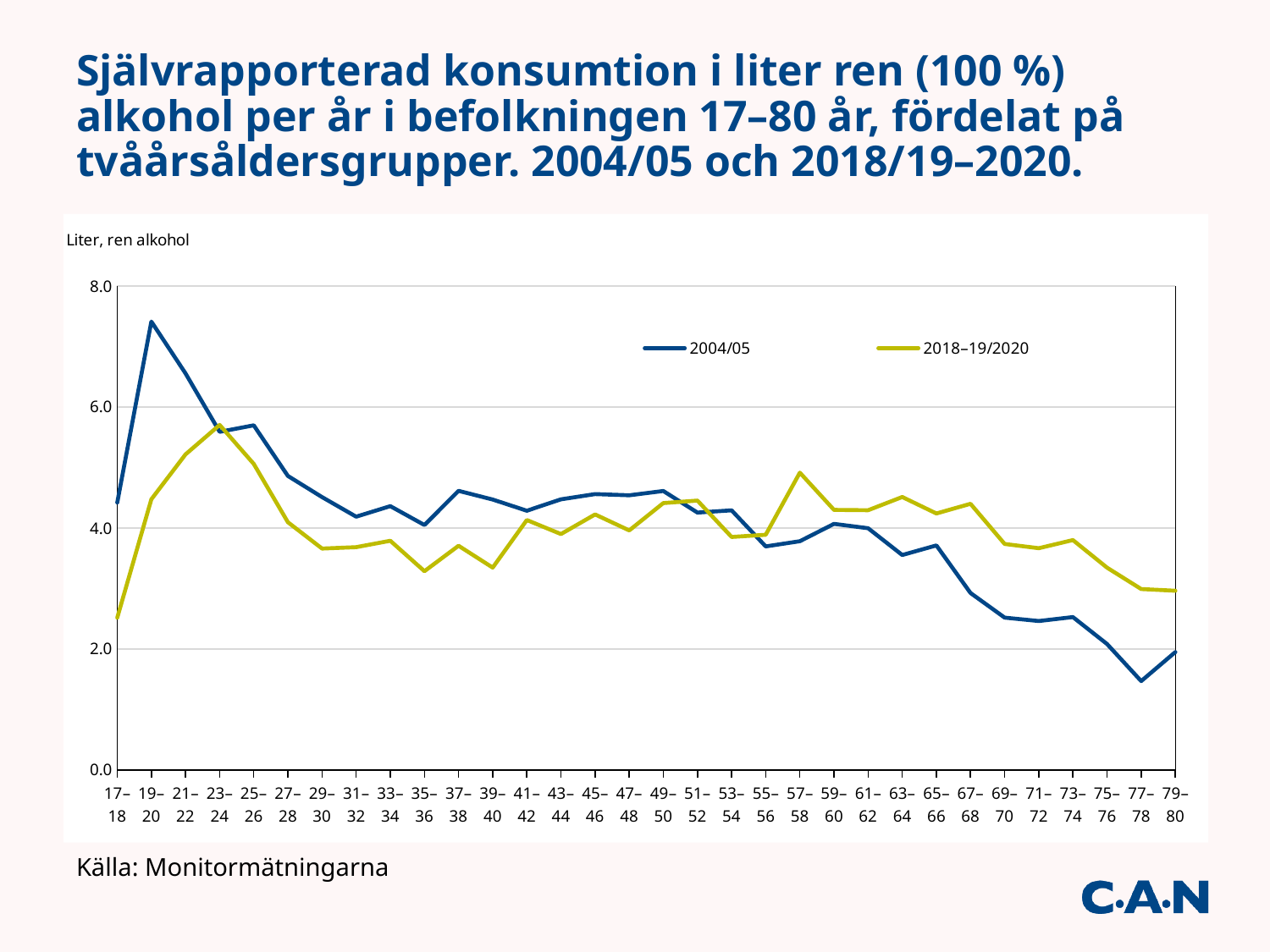
What kind of chart is shown on the slide? Line chart Is the 2004/05 value for the 19–20 age group greater or less than 6.0? greater For the 2018–19/2020 series, which age group has the highest value? 23–24 Does the 2004/05 series rise or fall from the 59–60 age group to the 77–78 age group? Fall What is the label shown above the y axis? Liter, ren alkohol For the 2004/05 series, which age group has the highest value? 19–20 How many series does the legend list? 2 For the 2004/05 series, which age group has the lowest value? 77–78 Is the 2018–19/2020 value for the 17–18 age group greater or less than 4.0? less For the 69–70 age group, which series has the higher value, 2004/05 or 2018–19/2020? 2018–19/2020 For the 2018–19/2020 series, which age group has the lowest value? 17–18 How many age groups are shown along the x axis? 32